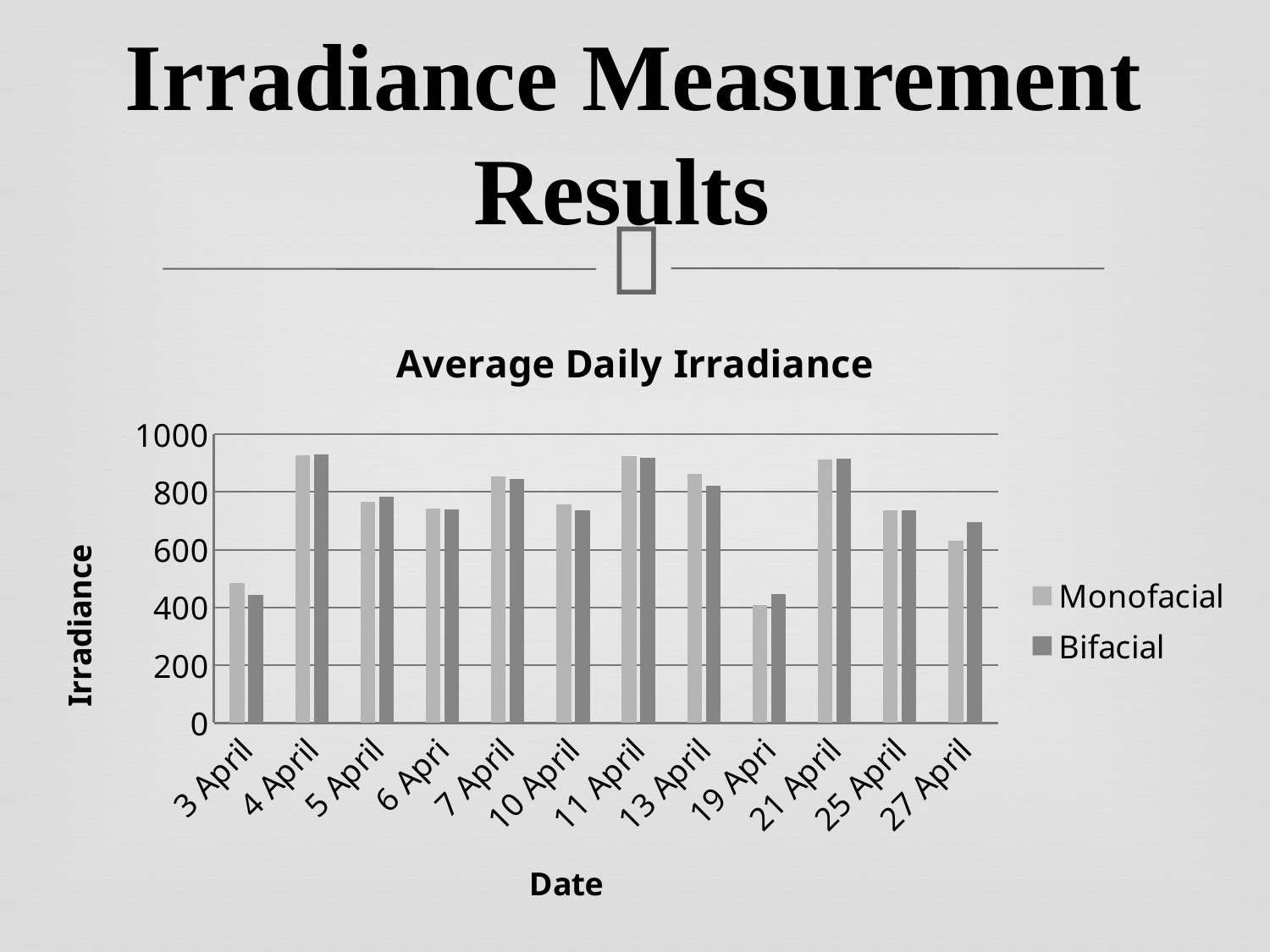
How many series does the legend list? 2 How many dates are shown on the x axis? 12 Is the Bifacial value for 27 April greater or less than 800? less What is the label of the vertical axis? Irradiance Is the Monofacial value for 3 April greater or less than 600? less Is the Bifacial value for 19 April greater or less than 600? less Which is larger, the Monofacial value for 5 April or the Monofacial value for 7 April? 7 April What kind of chart is shown on the slide? bar chart Which date has the lowest Monofacial value? 19 Apri On 27 April, which is larger, the Monofacial or the Bifacial value? Bifacial What is the title of the chart? Average Daily Irradiance